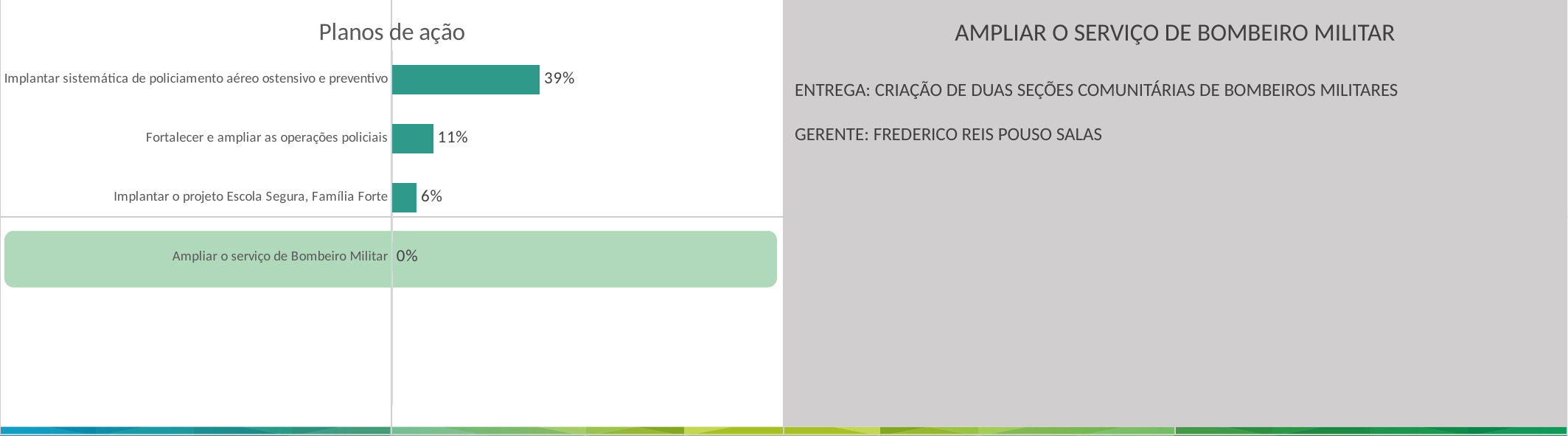
Which category has the highest value? Implantar sistemática de policiamento aéreo ostensivo e preventivo How many categories does the chart show? 4 What is the value for "Ampliar o serviço de Bombeiro Militar"? 0% What type of chart is shown on the slide? bar chart Which category has the lowest value? Ampliar o serviço de Bombeiro Militar What is the difference between the values for "Implantar sistemática de policiamento aéreo ostensivo e preventivo" and "Fortalecer e ampliar as operações policiais"? 28% What is the title of the chart? Planos de ação Which is larger: the value for "Fortalecer e ampliar as operações policiais" or for "Implantar o projeto Escola Segura, Família Forte"? Fortalecer e ampliar as operações policiais What is the value for "Fortalecer e ampliar as operações policiais"? 11% What is the value for "Implantar sistemática de policiamento aéreo ostensivo e preventivo"? 39% What is the value for "Implantar o projeto Escola Segura, Família Forte"? 6% Which category is highlighted with a green background on the slide? Ampliar o serviço de Bombeiro Militar